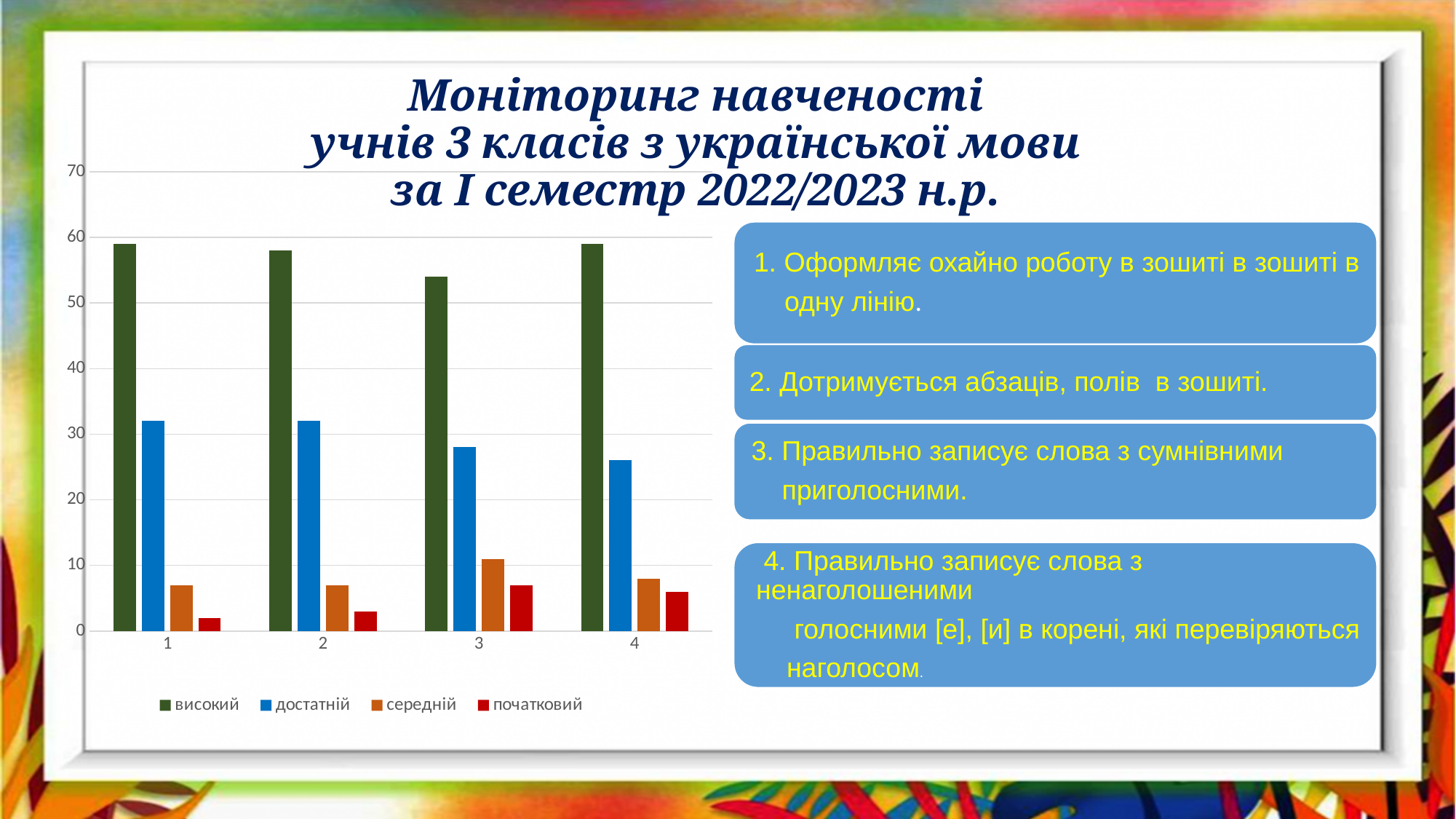
Which category has the highest value for середній? 3 Is the value for достатній in category 4 greater or less than 30? less Is the value for початковий in category 1 greater or less than 10? less Does the value for достатній rise or fall from category 2 to category 4? fall What kind of chart is shown on the slide? bar chart In category 3, which is larger: середній or початковий? середній How many categories are shown on the x axis? 4 In category 1, which is larger: високий or достатній? високий How many series does the legend list? 4 Which series is shown in green in the legend? високий Is the value for середній in category 3 greater or less than 20? less